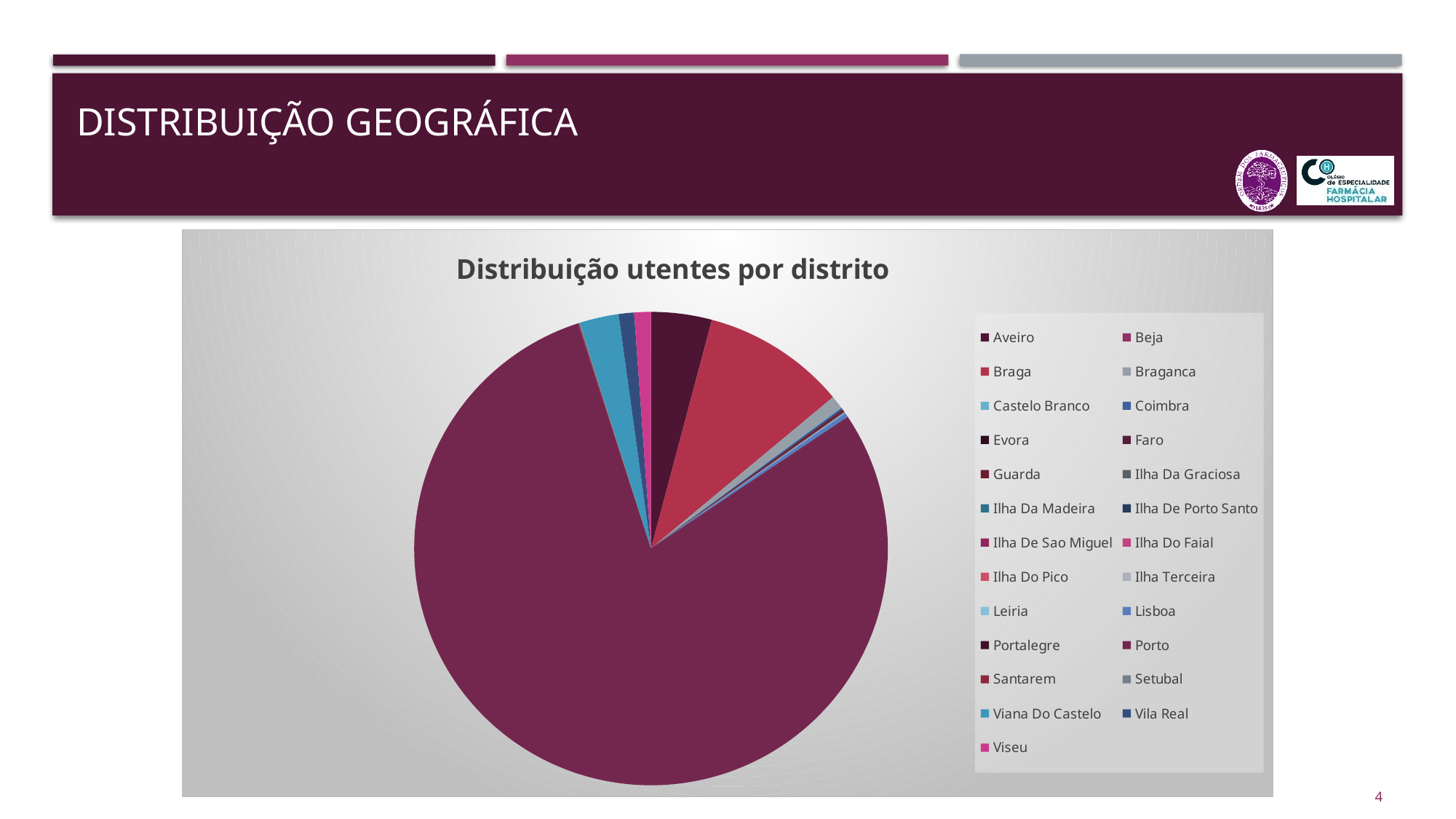
Does the largest slice of the pie chart account for more or less than half of the pie? more Which district is listed first in the legend of the pie chart? Aveiro How many districts are listed in the legend of the pie chart? 25 What is the title of the pie chart? Distribuição utentes por distrito What kind of chart is shown on the slide? pie chart